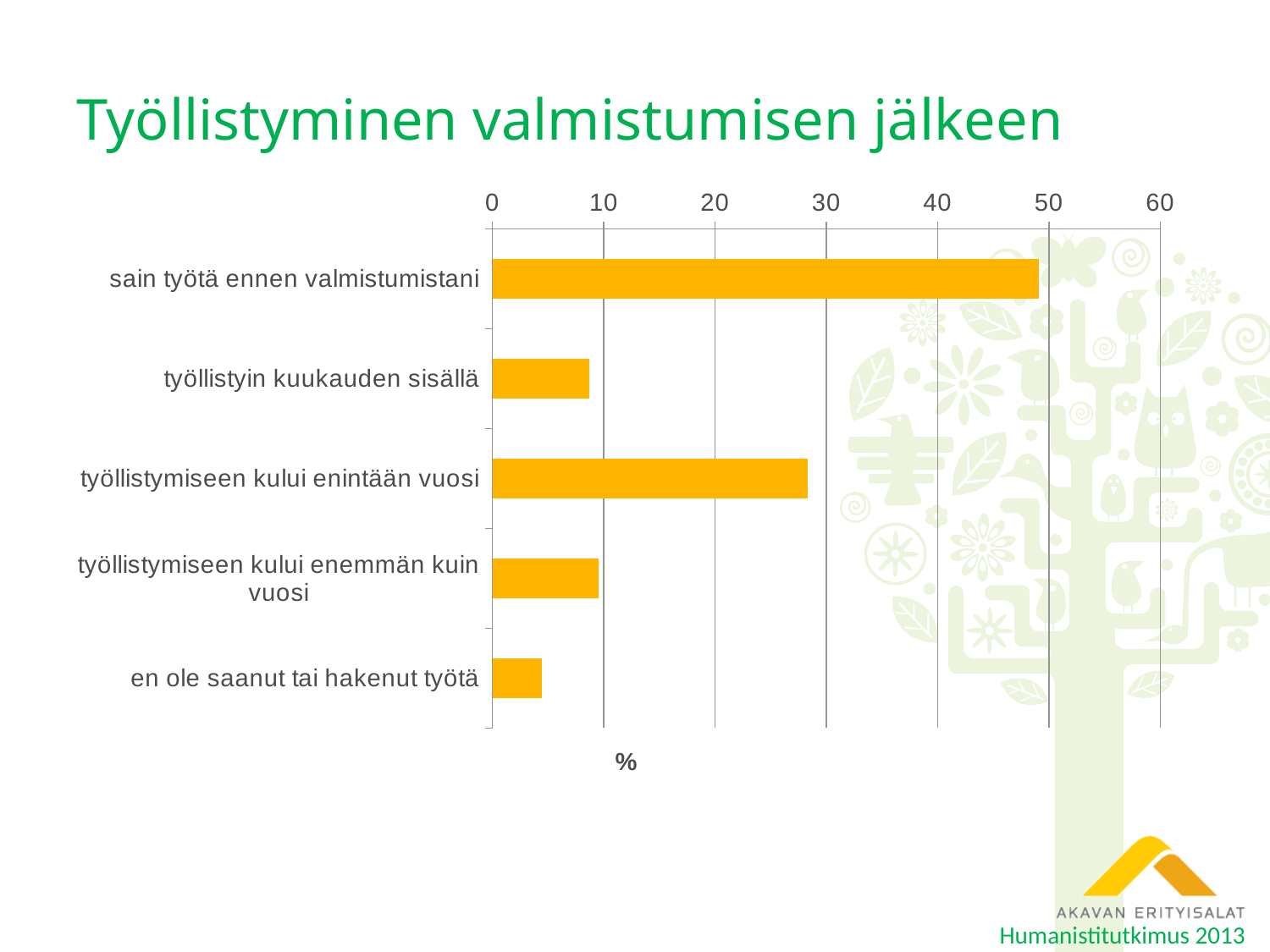
What kind of chart is shown on the slide? bar chart What is the title of the slide? Työllistyminen valmistumisen jälkeen Is the value for 'en ole saanut tai hakenut työtä' greater or less than 10? less Which is larger: the value for 'työllistymiseen kului enintään vuosi' or the value for 'työllistyin kuukauden sisällä'? työllistymiseen kului enintään vuosi Which category has the lowest value? en ole saanut tai hakenut työtä Is the value for 'sain työtä ennen valmistumistani' greater or less than 40? greater How many categories are shown in the chart? 5 Which category has the highest value? sain työtä ennen valmistumistani What unit label is shown below the value axis? % Is the value for 'työllistymiseen kului enintään vuosi' greater or less than 30? less